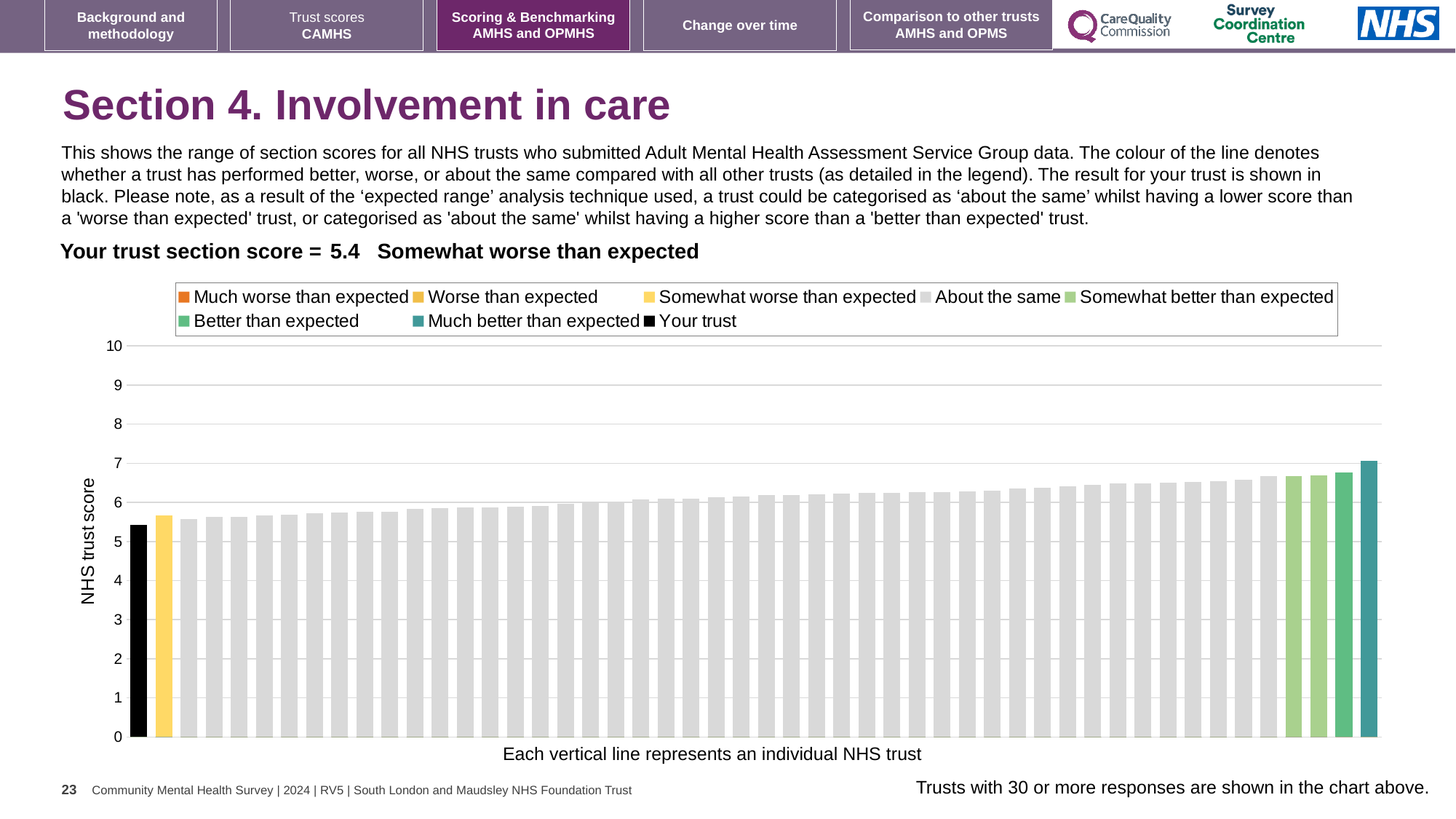
Which performance category is your trust's section score placed in? Somewhat worse than expected Do the bar values rise or fall from left to right along the x axis? rise Is the value for the rightmost bar greater or less than 6? greater What is the section score for your trust? 5.4 What colour is the bar representing your trust? black Is the value for the lowest bar greater or less than 5? greater What is the highest value shown on the y axis? 10 Is the value for your trust greater or less than 6? less Which is larger, the leftmost bar or the rightmost bar? the rightmost bar How many entries does the chart legend list? 8 What kind of chart is shown on the slide? bar chart